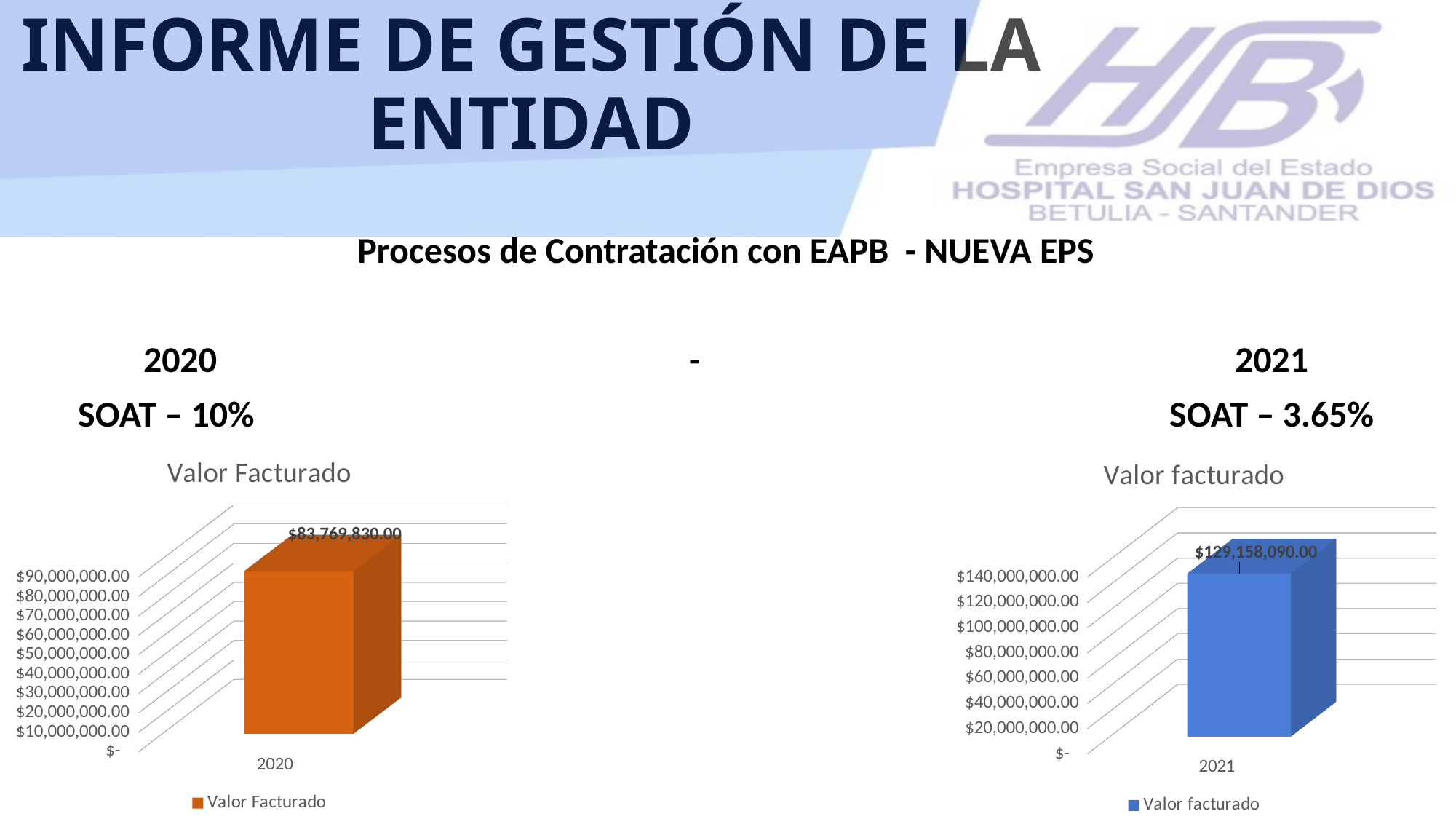
What is the difference between the 2021 value in the right chart and the 2020 value in the left chart? $45,388,260.00 In the left chart (2020), what is the value labelled on the bar for 2020? $83,769,830.00 How many series does the legend of the left chart (2020) list? 1 In the right chart (2021), is the value for 2021 greater or less than $140,000,000.00? less How many bars are plotted in the left chart (2020)? 1 What is the legend entry shown below the right chart (2021)? Valor facturado How many bars are plotted in the right chart (2021)? 1 In the right chart (2021), what is the value labelled on the bar for 2021? $129,158,090.00 Which is larger: the 2020 value in the left chart or the 2021 value in the right chart? 2021 What type of chart is the right chart titled 'Valor facturado'? bar chart What type of chart is the left chart titled 'Valor Facturado'? bar chart In the left chart (2020), is the value for 2020 greater or less than $80,000,000.00? greater